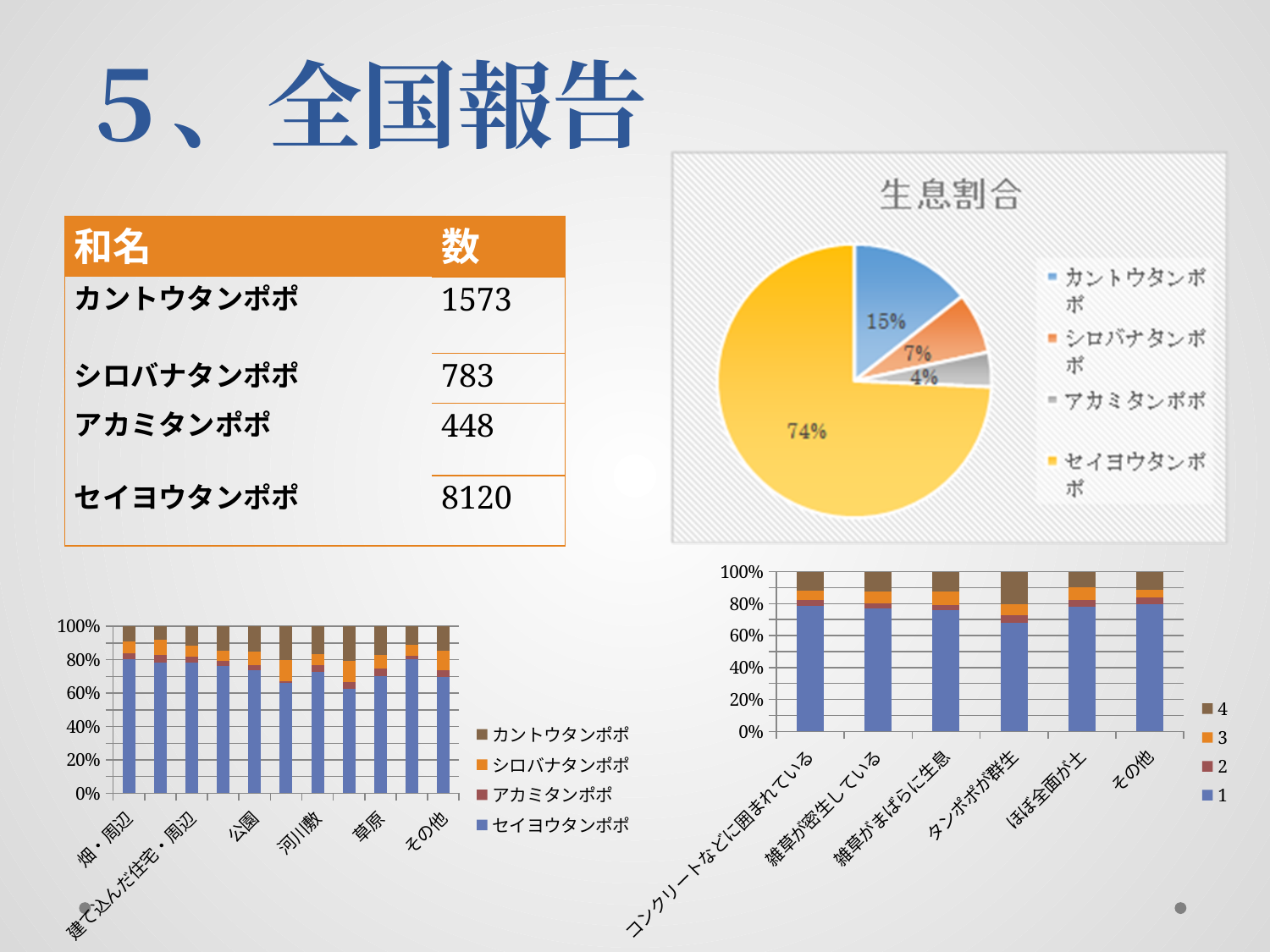
In the pie chart titled 生息割合, which category has the smallest slice? アカミタンポポ In the pie chart titled 生息割合, which category has the largest slice? セイヨウタンポポ In the pie chart titled 生息割合, what is the difference in percentage points between the シロバナタンポポ slice and the アカミタンポポ slice? 3% In the pie chart titled 生息割合, what share does アカミタンポポ have? 4% In the pie chart titled 生息割合, how many entries does the legend list? 4 What kind of chart is the chart titled 生息割合? pie chart In the pie chart titled 生息割合, what share does セイヨウタンポポ have? 74% In the pie chart titled 生息割合, what share does カントウタンポポ have? 15% In the bar chart at the bottom right of the slide, how many categories are shown on the x axis? 6 What kind of chart is the chart at the bottom right of the slide? stacked bar chart In the bar chart at the bottom left of the slide, how many series does the legend list? 4 In the bar chart at the bottom right of the slide, is the value of series 1 for タンポポが群生 greater or less than 80%? less